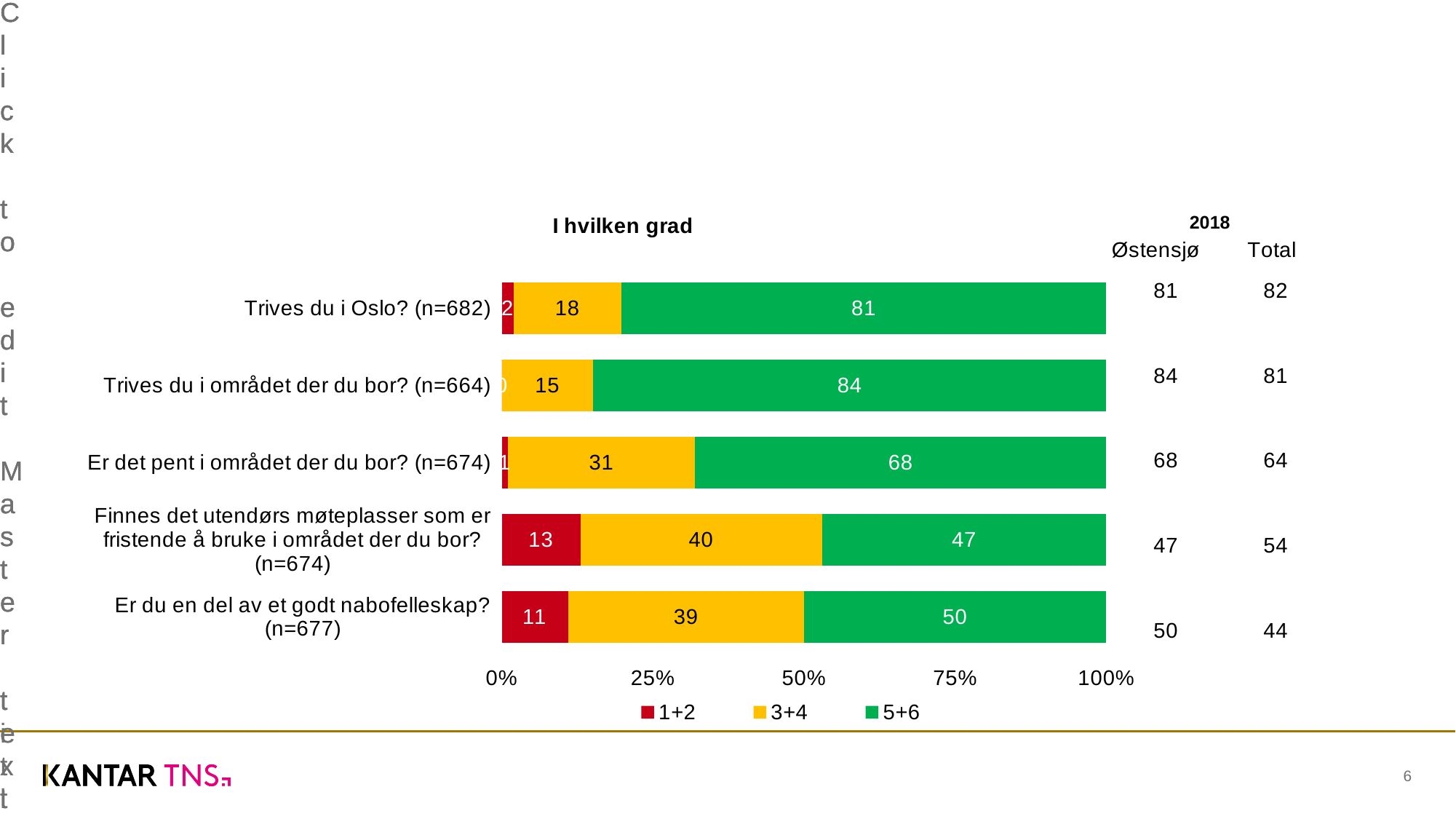
Which category has the lowest 5+6 value? Finnes det utendørs møteplasser som er fristende å bruke i området der du bor? (n=674) Which colour represents the 5+6 series in the chart? green What type of chart is shown on the slide? stacked bar chart Which category has the highest 5+6 value? Trives du i området der du bor? (n=664) How many series does the legend list? 3 What is the title of the chart? I hvilken grad What is the 5+6 value for "Trives du i området der du bor? (n=664)"? 84 What is the 1+2 value for "Finnes det utendørs møteplasser som er fristende å bruke i området der du bor? (n=674)"? 13 How many question categories are plotted in the chart? 5 Which is larger: the 1+2 value for "Finnes det utendørs møteplasser..." or for "Er du en del av et godt nabofelleskap?"? Finnes det utendørs møteplasser som er fristende å bruke i området der du bor? (n=674) What is the 3+4 value for "Er det pent i området der du bor? (n=674)"? 31 What is the difference between the 3+4 values for "Er du en del av et godt nabofelleskap? (n=677)" and "Trives du i Oslo? (n=682)"? 21